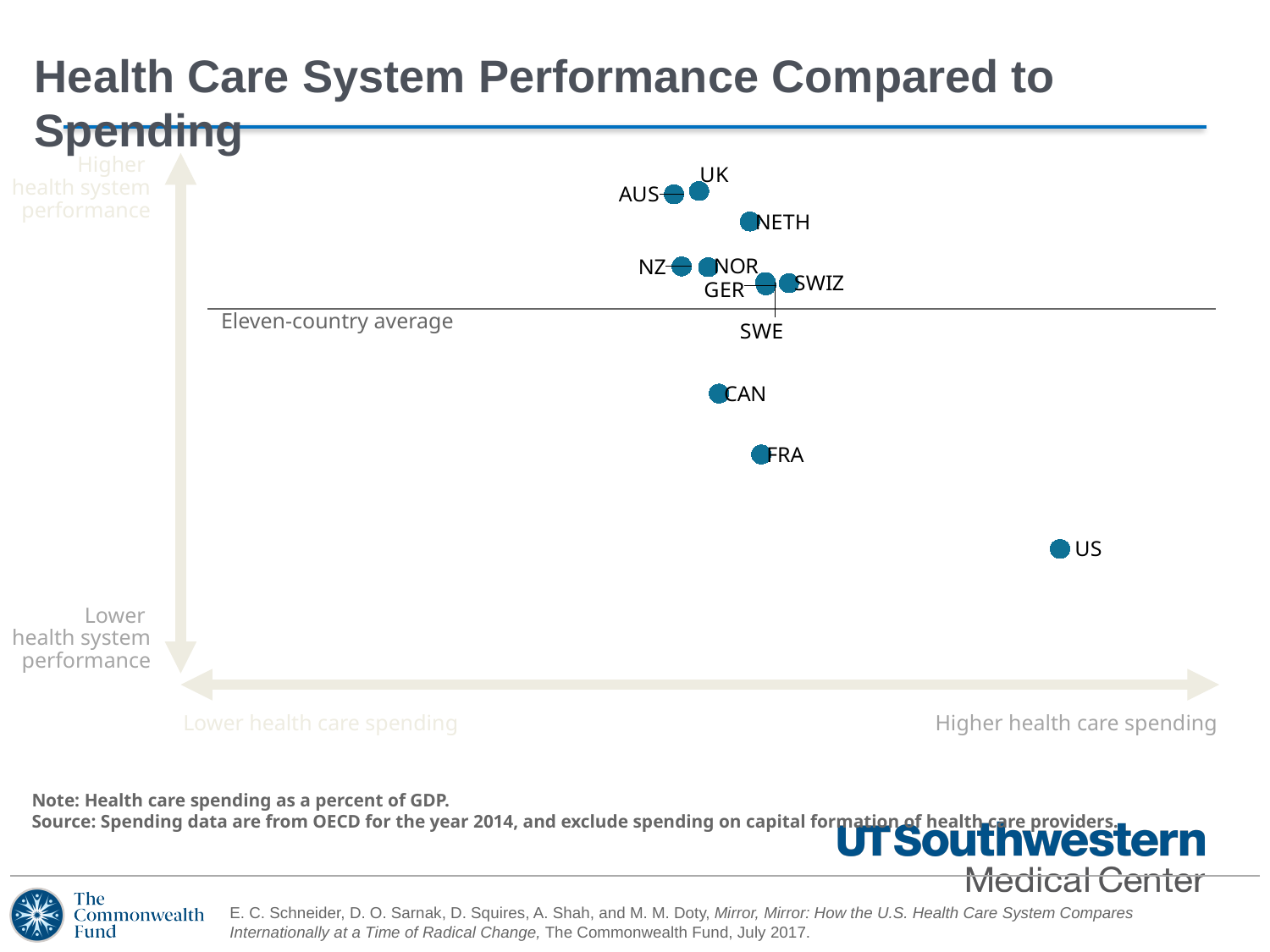
What does the horizontal axis of the chart represent? Health care spending (lower to higher) Which country has higher health care spending, US or CAN? US What kind of chart is shown on the slide? Scatter plot Which country has the highest health system performance on the chart? UK Which country has higher health system performance, NETH or FRA? NETH What is the title of the chart? Health Care System Performance Compared to Spending How many countries are plotted on the chart? 11 Which country has the lowest health system performance on the chart? US Which country has the highest health care spending on the chart? US Which country has higher health care spending, SWIZ or AUS? SWIZ